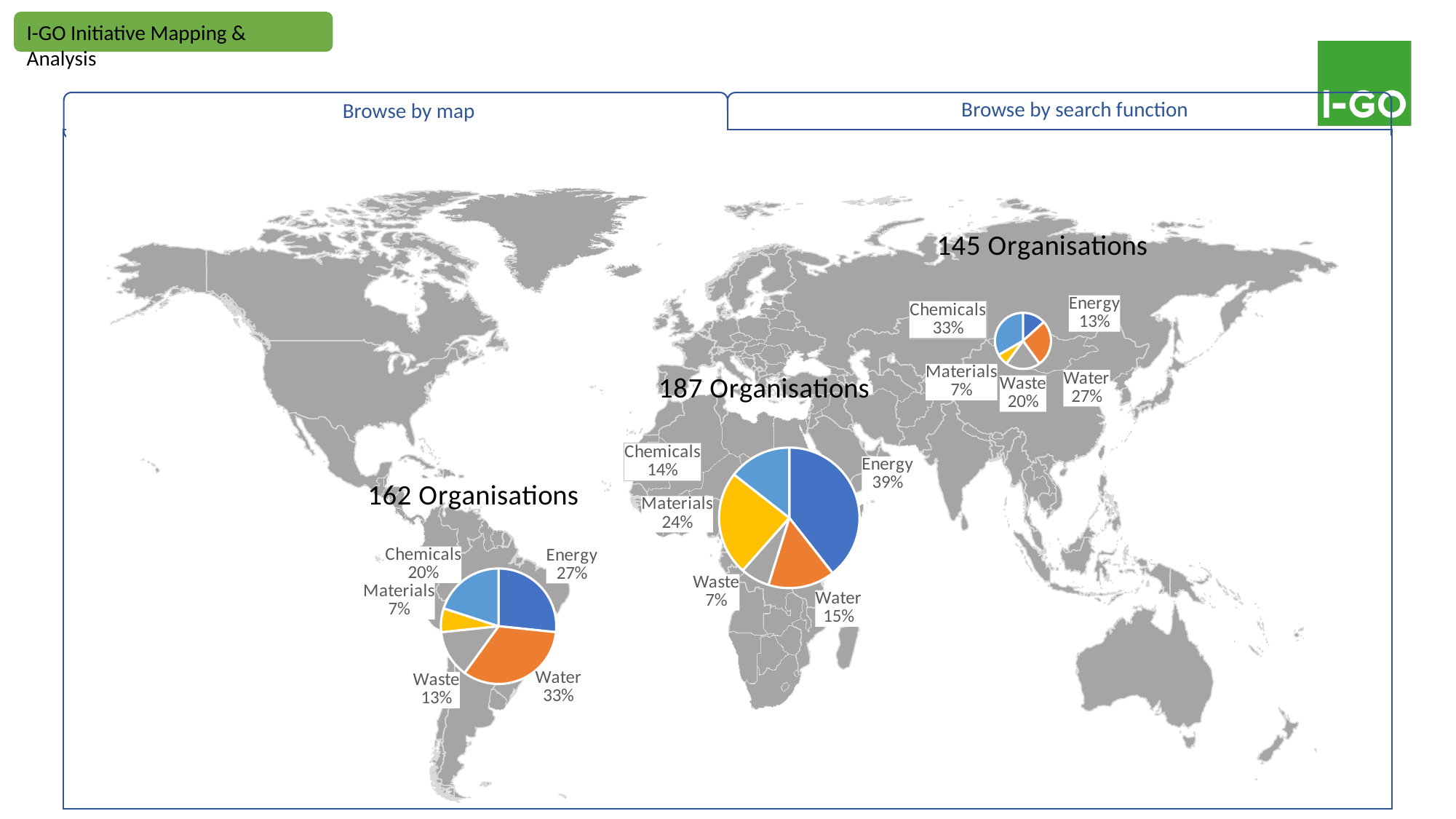
What type of chart is used for the "162 Organisations" data? Pie chart In the pie chart labelled "187 Organisations", which category has the largest share? Energy In the pie chart labelled "145 Organisations", which category has the smallest share? Materials In the pie chart labelled "145 Organisations", which is larger, Water or Energy? Water In the pie chart labelled "162 Organisations", which is larger, Chemicals or Waste? Chemicals In the pie chart labelled "162 Organisations", which category has the smallest share? Materials In the pie chart labelled "162 Organisations", what share is Water? 33% In the pie chart labelled "187 Organisations", what is the difference in percentage points between Energy and Water? 24 How many pie charts are shown on the map? 3 In the pie chart labelled "145 Organisations", what share is Chemicals? 33% How many slices does the pie chart labelled "187 Organisations" have? 5 In the pie chart labelled "187 Organisations", what share is Energy? 39%